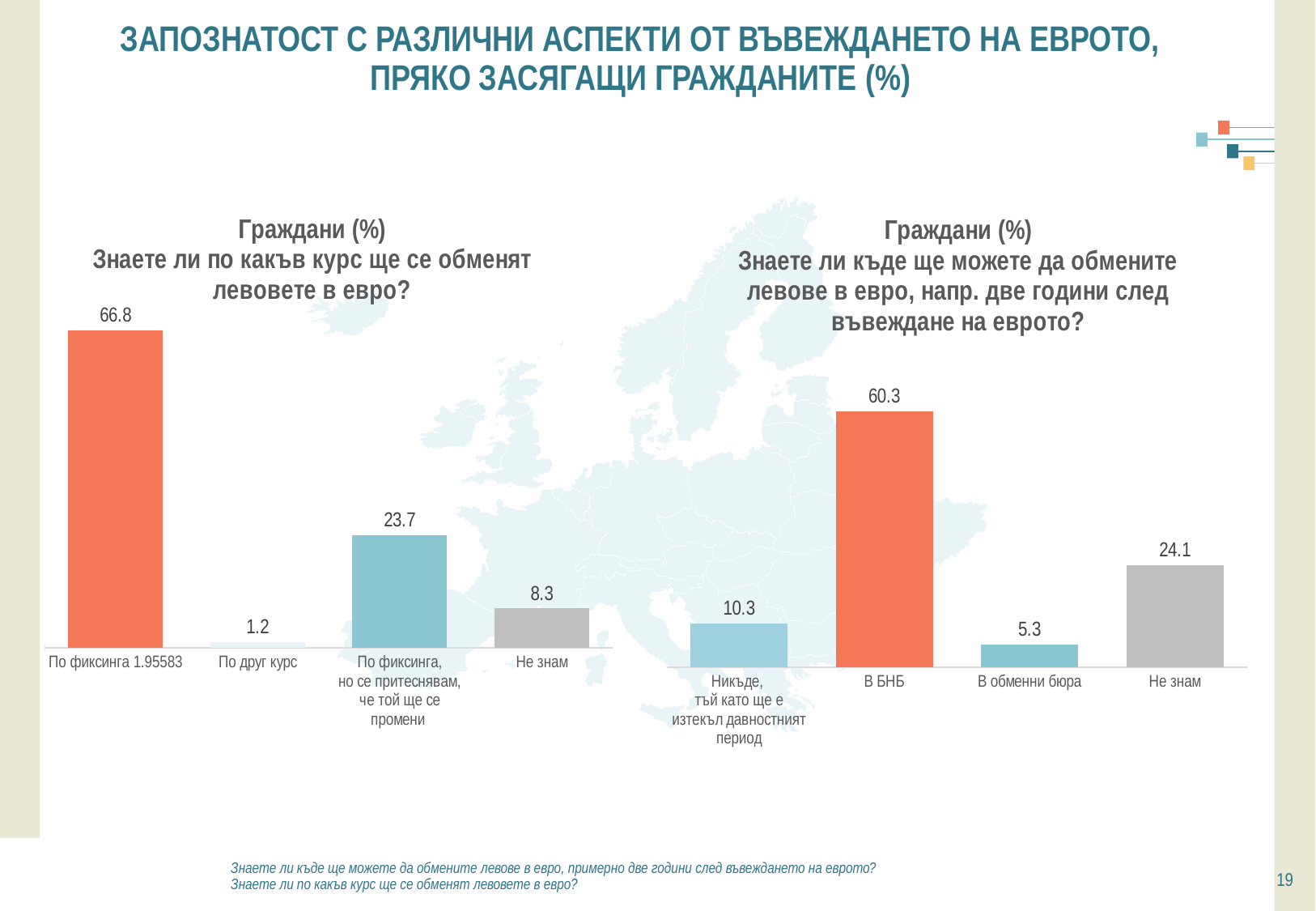
In the left chart (Знаете ли по какъв курс ще се обменят левовете в евро?), what colour is the bar for 'По фиксинга 1.95583'? Orange In the right chart (Знаете ли къде ще можете да обмените левове в евро...?), what is the value for 'В БНБ'? 60.3 In the left chart (Знаете ли по какъв курс ще се обменят левовете в евро?), which category has the lowest value? По друг курс In the left chart (Знаете ли по какъв курс ще се обменят левовете в евро?), what is the difference between 'По фиксинга, но се притеснявам, че той ще се промени' and 'Не знам'? 15.4 In the left chart (Знаете ли по какъв курс ще се обменят левовете в евро?), what is the value for 'По друг курс'? 1.2 In the left chart (Знаете ли по какъв курс ще се обменят левовете в евро?), how many categories are shown? 4 In the right chart (Знаете ли къде ще можете да обмените левове в евро...?), which is larger: 'Никъде, тъй като ще е изтекъл давностният период' or 'Не знам'? Не знам In the right chart (Знаете ли къде ще можете да обмените левове в евро...?), what is the difference between 'Не знам' and 'Никъде, тъй като ще е изтекъл давностният период'? 13.8 In the left chart (Знаете ли по какъв курс ще се обменят левовете в евро?), what is the value for 'По фиксинга 1.95583'? 66.8 In the right chart (Знаете ли къде ще можете да обмените левове в евро...?), which category has the highest value? В БНБ What type of chart is the right chart (Знаете ли къде ще можете да обмените левове в евро...?)? Bar chart In the right chart (Знаете ли къде ще можете да обмените левове в евро...?), what is the value for 'В обменни бюра'? 5.3